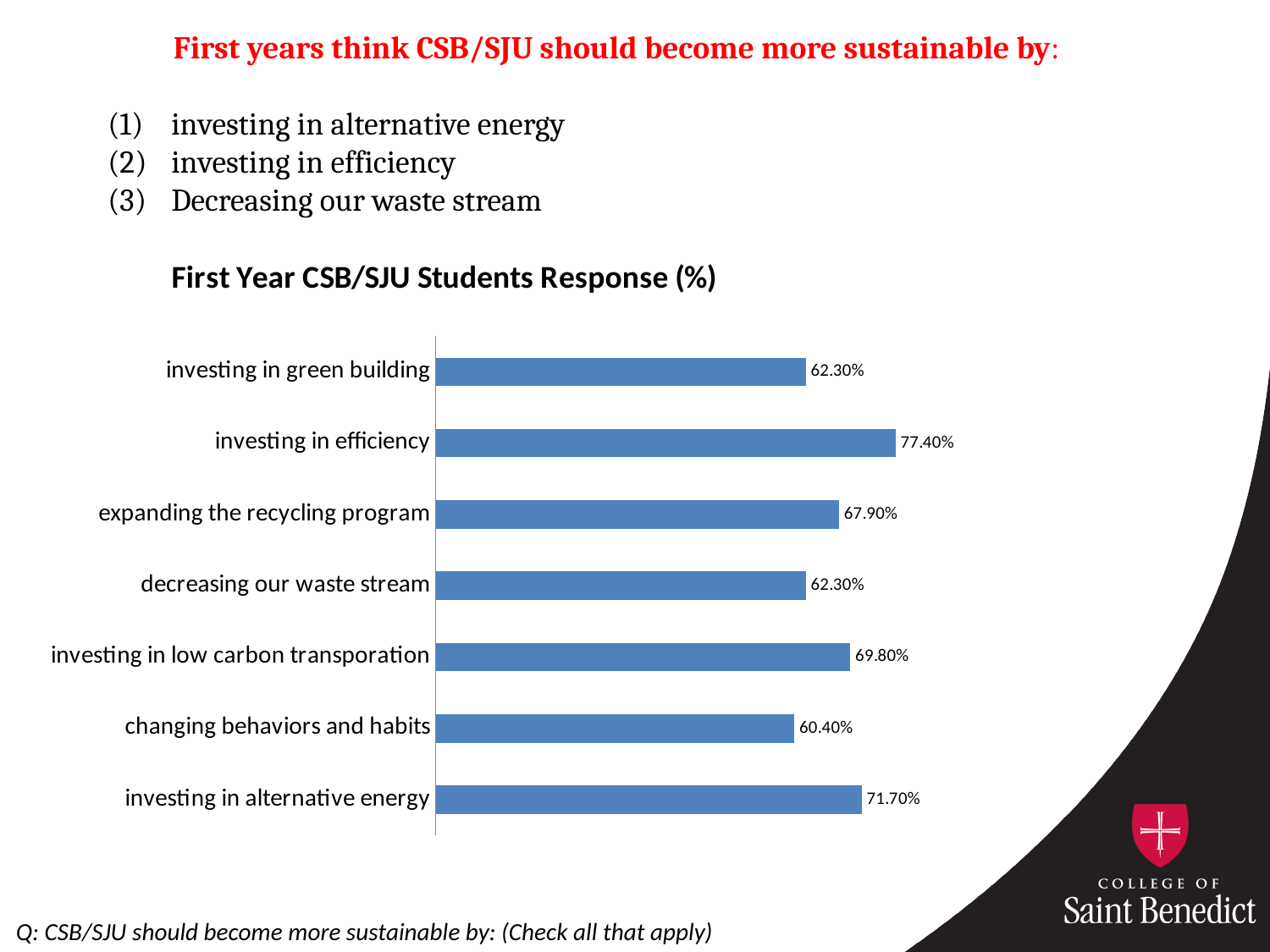
What is the difference between investing in efficiency and investing in alternative energy? 5.70% What kind of chart is shown? bar chart Which is larger, expanding the recycling program or investing in low carbon transporation? investing in low carbon transporation What is the value for changing behaviors and habits? 60.40% Which category has the highest value? investing in efficiency Which category has the lowest value? changing behaviors and habits What is the value for investing in efficiency? 77.40% What is the value for investing in alternative energy? 71.70% What is the title of the chart? First Year CSB/SJU Students Response (%) How many categories are shown in the chart? 7 What is the difference between investing in low carbon transporation and changing behaviors and habits? 9.40% What is the value for expanding the recycling program? 67.90%